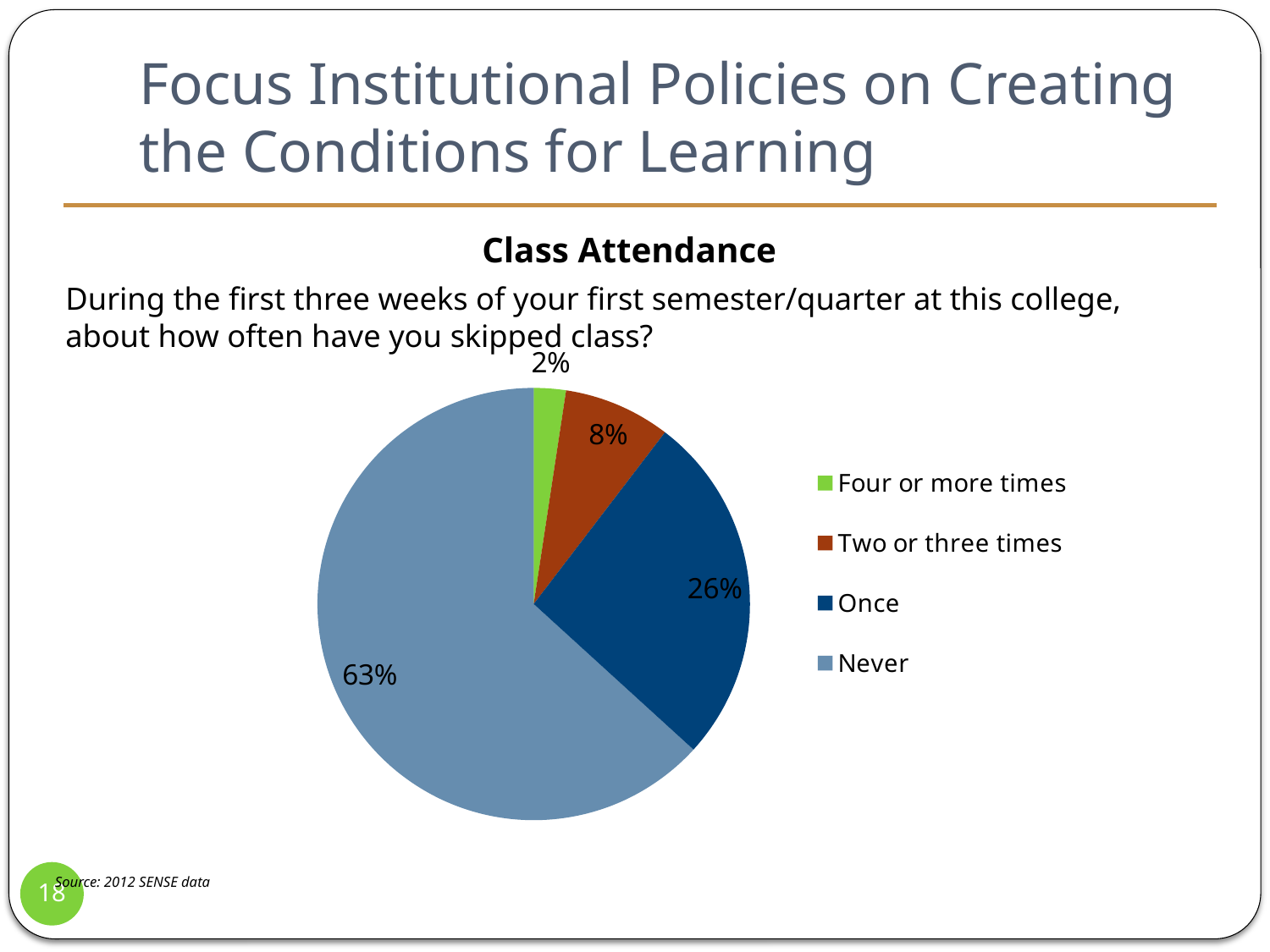
What is the title of the chart? Class Attendance How many categories does the legend list? 4 What is the difference in percentage points between "Never" and "Once"? 37 Which response category has the smallest share of the pie? Four or more times Which is larger, the share for "Once" or the share for "Two or three times"? Once What percentage of students answered "Never"? 63% Which response category has the largest share of the pie? Never What percentage of students answered "Four or more times"? 2% What colour is the "Four or more times" slice? green What type of chart is shown on the slide? pie chart What percentage of students answered "Once"? 26% What percentage of students answered "Two or three times"? 8%